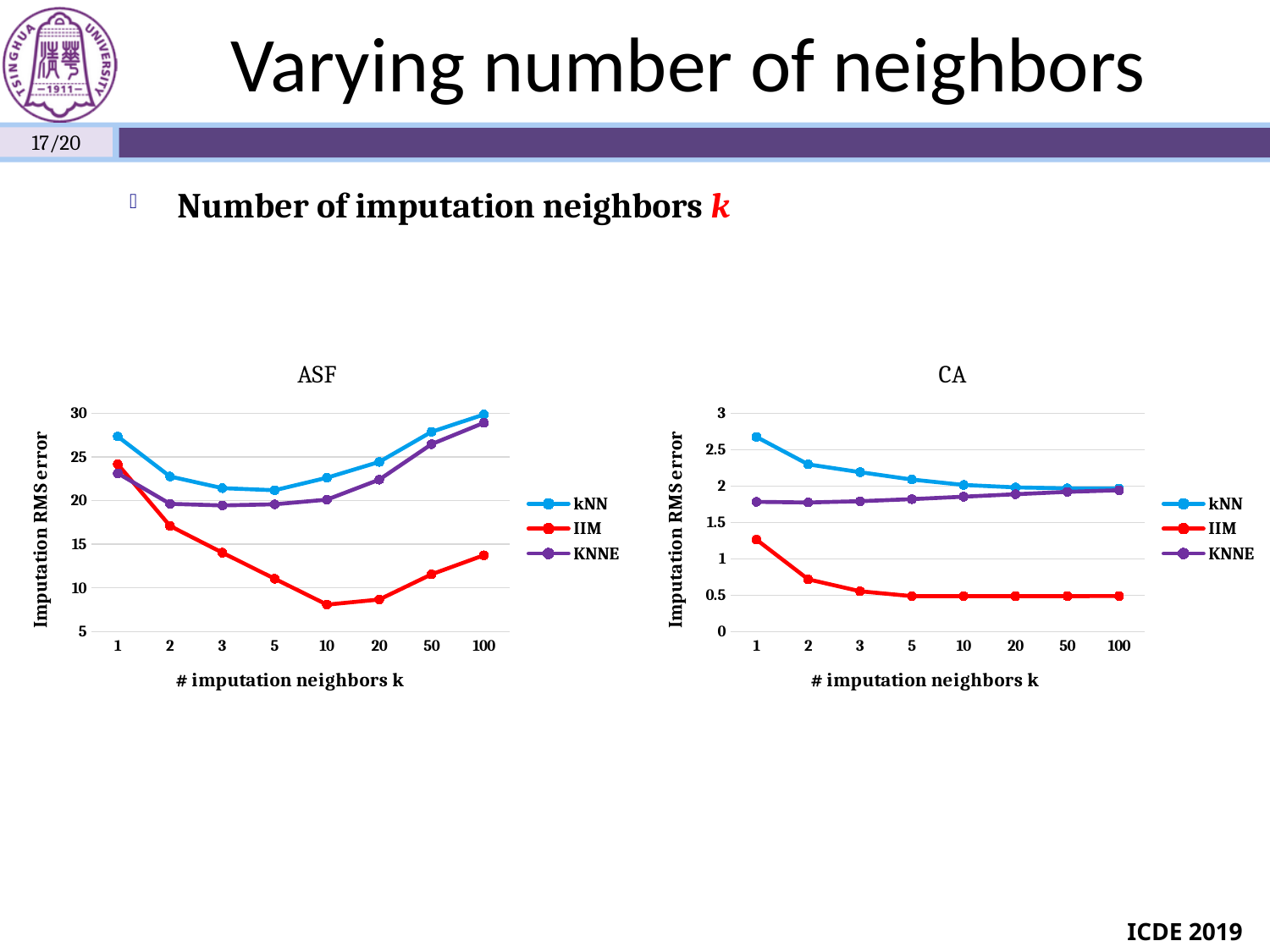
In the CA chart, is the kNN value at k = 1 greater or less than 2.5? greater How many values of k are plotted along the x axis of the ASF chart? 8 How many series does the legend of the CA chart list? 3 In the ASF chart, is the IIM value at k = 10 greater or less than 10? less In the ASF chart, does the IIM line rise or fall from k = 1 to k = 10? fall What is the y-axis label of the CA chart? Imputation RMS error In the ASF chart, which series has the lowest imputation RMS error at k = 10? IIM In the CA chart, which is larger at k = 1, the kNN value or the IIM value? kNN What kind of chart is the ASF chart? line chart In the ASF chart, is the kNN value at k = 1 greater or less than 25? greater In the ASF chart, which series has the highest imputation RMS error at k = 1? kNN In the CA chart, does the kNN line rise or fall as k increases from 1 to 100? fall